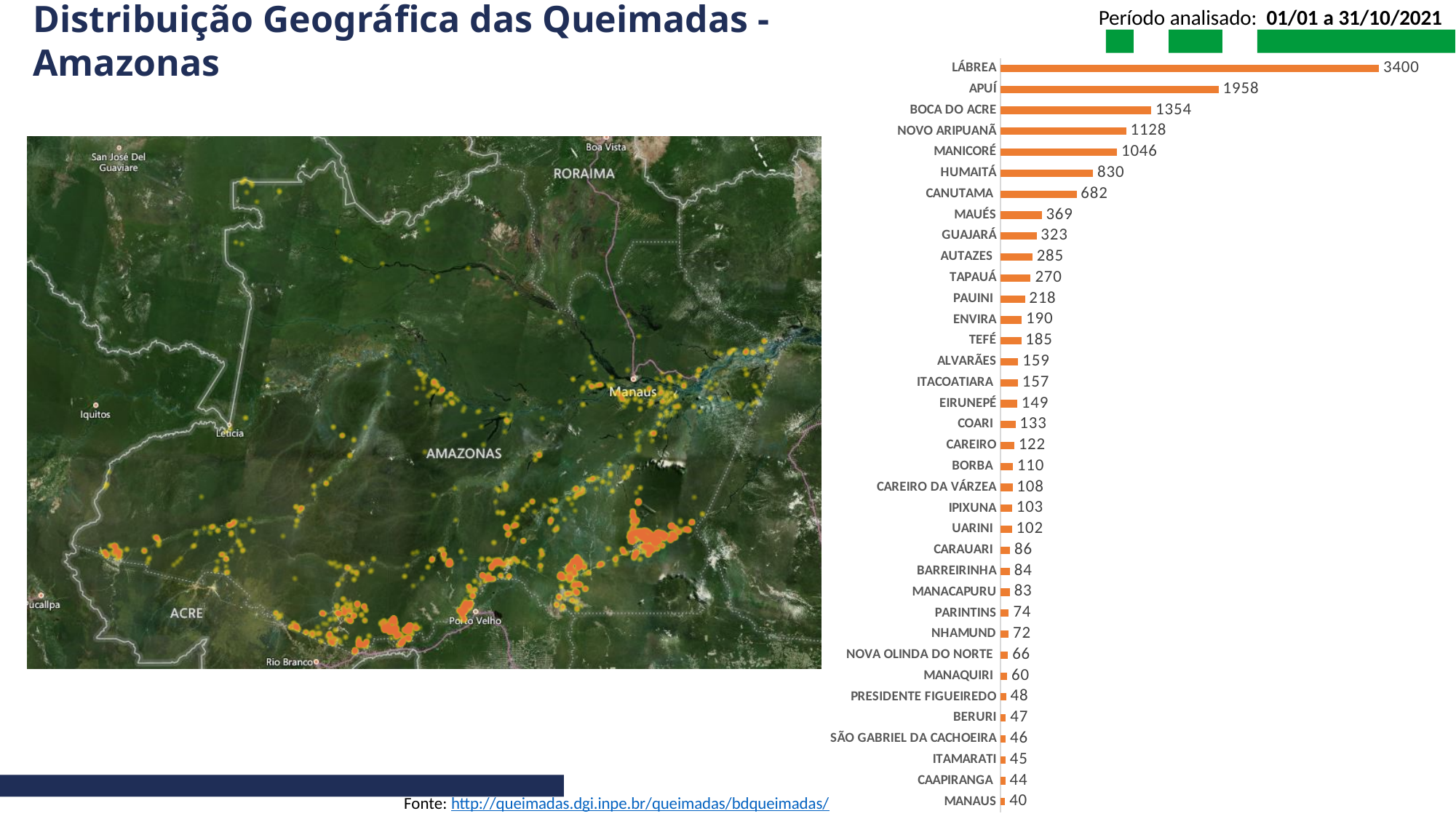
Which has a larger value, CANUTAMA or MAUÉS? CANUTAMA Which has a larger value, TEFÉ or ENVIRA? ENVIRA What is the difference between the values for LÁBREA and APUÍ? 1442 How many municipalities are listed in the bar chart? 36 Which municipality has the highest value in the chart? LÁBREA What is the value for HUMAITÁ? 830 What kind of chart is shown on the right side of the slide? bar chart What is the difference between the values for BOCA DO ACRE and NOVO ARIPUANÃ? 226 Which municipality has the lowest value in the chart? MANAUS What is the value for LÁBREA? 3400 What period is stated as analysed on the slide? 01/01 a 31/10/2021 What is the value for MANAUS? 40